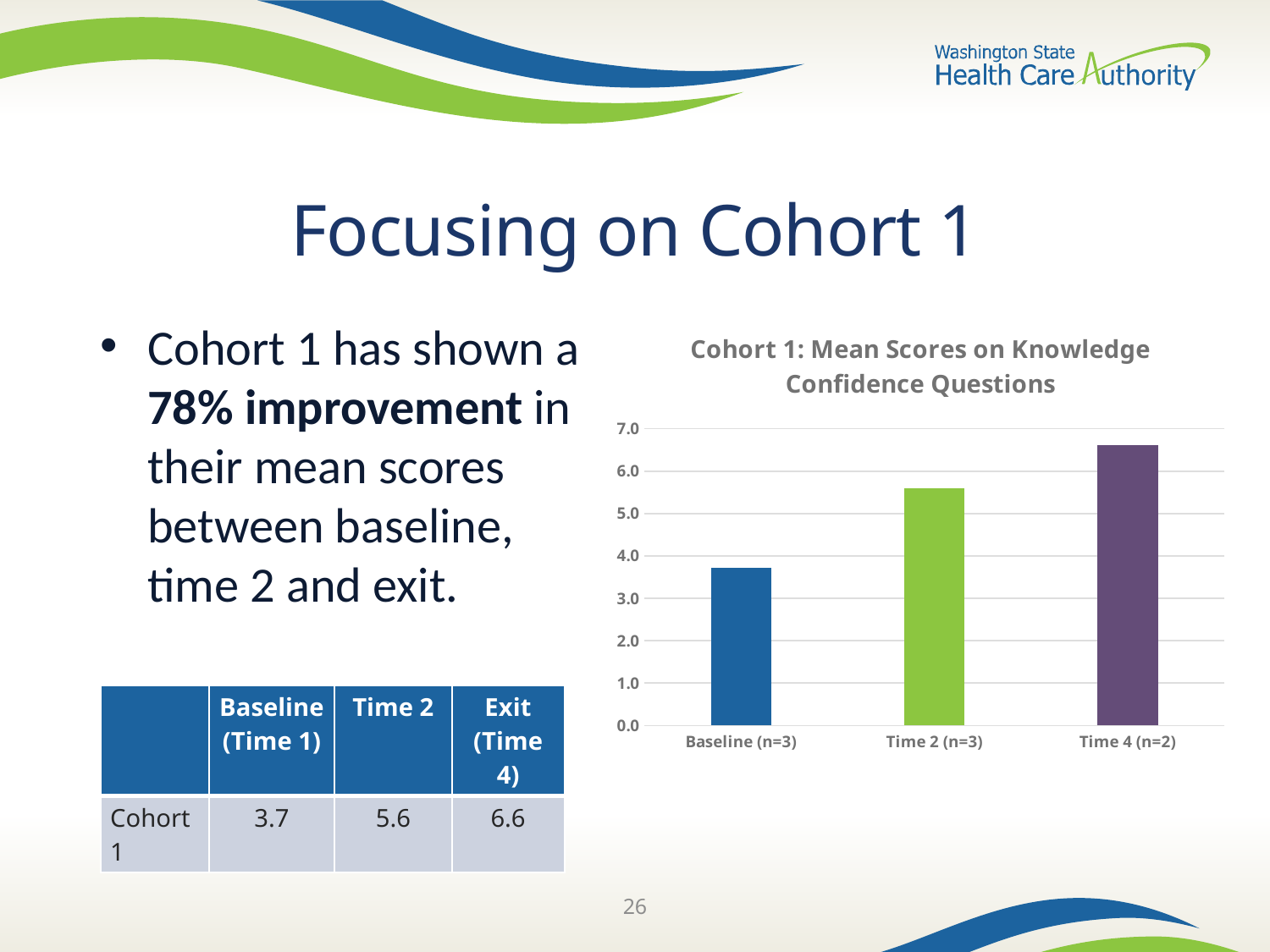
Is the value for Time 2 (n=3) greater or less than 5.0? greater Which category has the lowest mean score in the chart? Baseline (n=3) Which category has the highest mean score in the chart? Time 4 (n=2) How many bars are plotted in the chart? 3 Is the value for Baseline (n=3) greater or less than 4.0? less Using the values printed on the slide, what is the difference between the Exit (Time 4) mean score and the Baseline (Time 1) mean score for Cohort 1? 2.9 What is the title of the chart? Cohort 1: Mean Scores on Knowledge Confidence Questions Which is larger, the value for Time 2 (n=3) or the value for Baseline (n=3)? Time 2 (n=3) According to the slide, what is the mean score for Cohort 1 at Time 2? 5.6 Is the value for Time 4 (n=2) greater or less than 6.0? greater What type of chart is shown on the slide? bar chart Do the mean scores rise or fall from Baseline to Time 4 along the x axis? rise